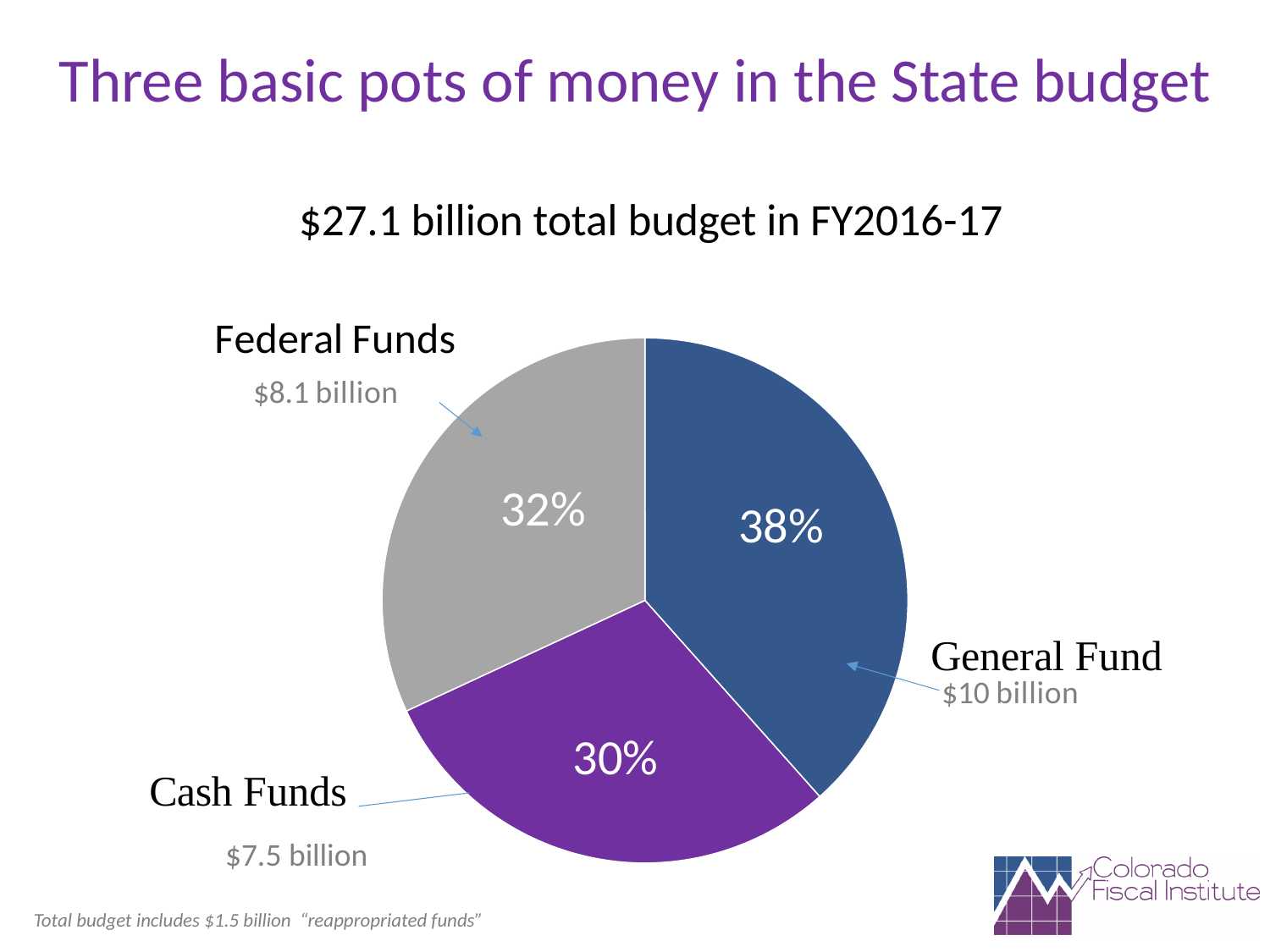
What is the dollar amount shown for Cash Funds? $7.5 billion What share of the budget do Federal Funds represent? 32% What is the difference in percentage points between the General Fund and Cash Funds shares? 8 percentage points Which pot of money is the smallest slice of the pie? Cash Funds What share of the budget do Cash Funds represent? 30% What kind of chart is shown on the slide? pie chart How many slices does the pie chart have? 3 What share of the budget does the General Fund represent? 38% Which pot of money is the largest slice of the pie? General Fund What is the total budget stated on the slide for FY2016-17? $27.1 billion What is the dollar amount shown for Federal Funds? $8.1 billion What is the dollar amount shown for the General Fund? $10 billion